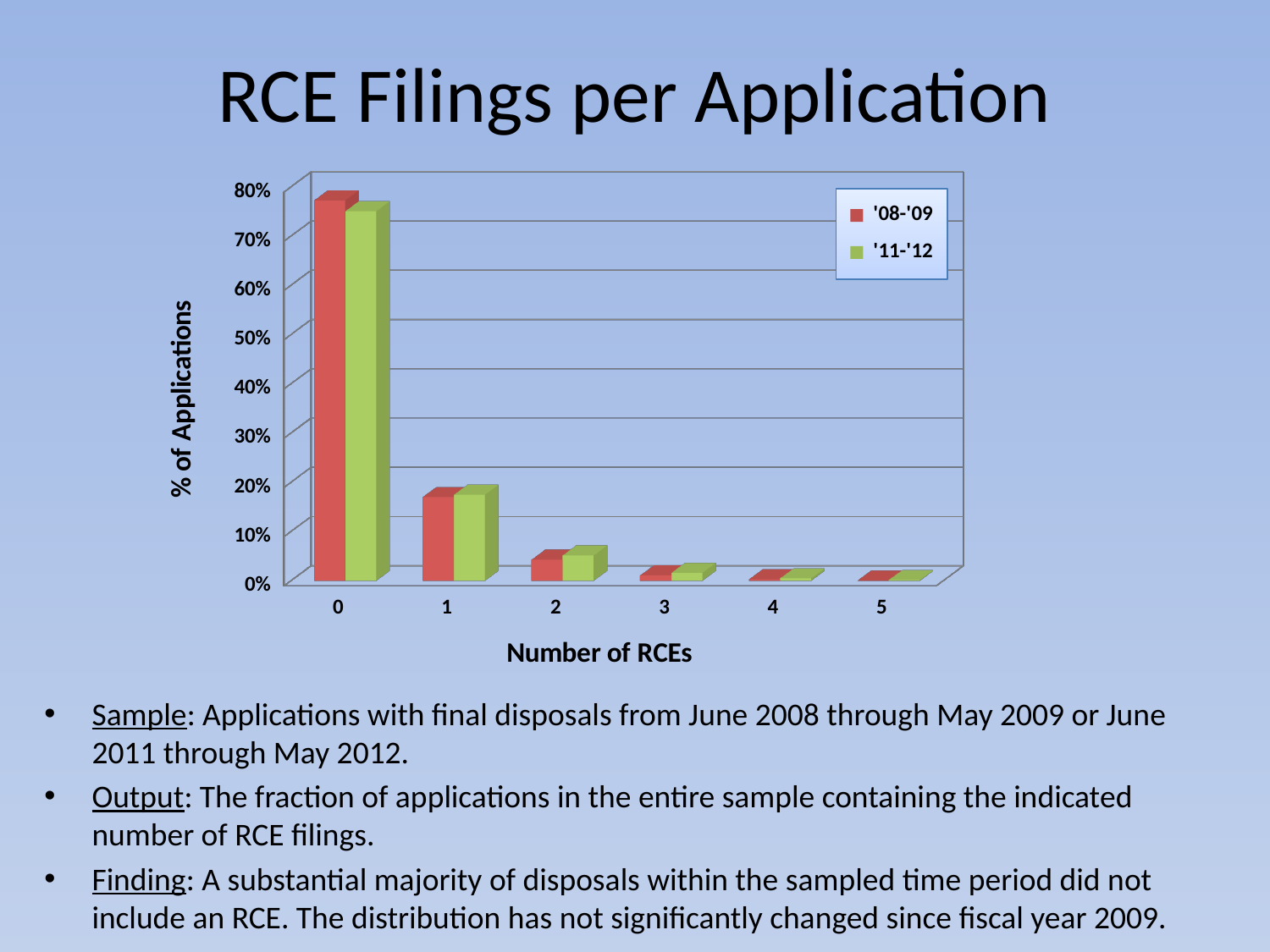
How many categories are shown on the x axis (Number of RCEs)? 6 For the '08-'09 series, which is larger: the value for 0 RCEs or the value for 1 RCE? 0 RCEs What kind of chart is shown on the slide? bar chart Which number of RCEs has the highest value for the '11-'12 series? 0 Is the '11-'12 value for 1 RCE greater or less than 20%? less Which number of RCEs has the highest value for the '08-'09 series? 0 What is the title of the chart? RCE Filings per Application How many series does the legend list? 2 Is the '08-'09 value for 0 RCEs greater or less than 70%? greater Do the values rise or fall as the number of RCEs increases along the x axis? fall Is the '08-'09 value for 2 RCEs greater or less than 10%? less What is the label of the y axis? % of Applications